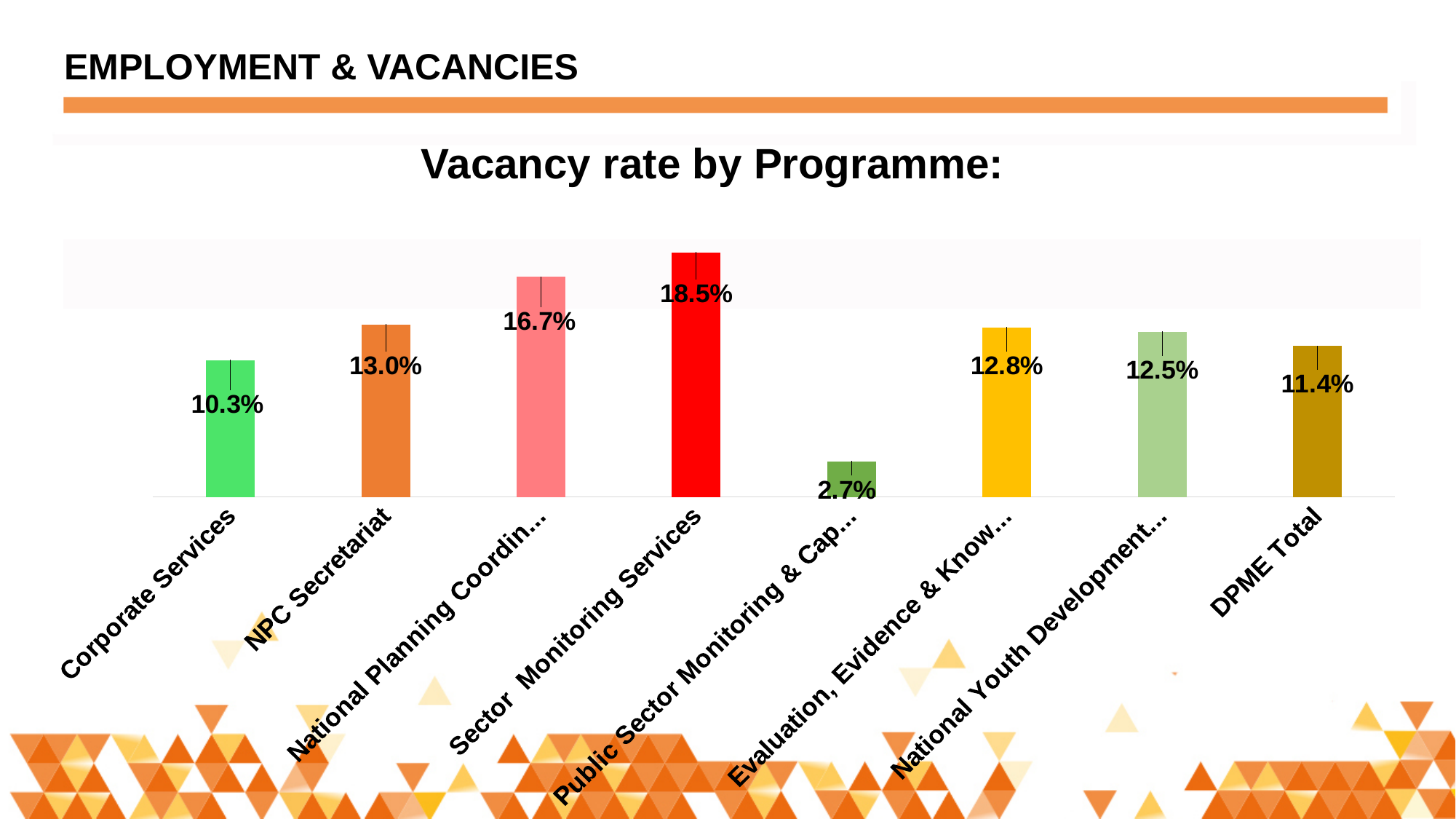
What is the vacancy rate for Sector Monitoring Services? 18.5% Which has a higher vacancy rate, NPC Secretariat or DPME Total? NPC Secretariat What type of chart is shown on the slide? Bar chart Which programme has the highest vacancy rate? Sector Monitoring Services What is the title of the chart? Vacancy rate by Programme: What is the vacancy rate for Corporate Services? 10.3% What is the vacancy rate for DPME Total? 11.4% What is the difference between the vacancy rates of Sector Monitoring Services and Corporate Services? 8.2% Which bar shows the lowest vacancy rate? Public Sector Monitoring & Cap... What is the vacancy rate for NPC Secretariat? 13.0% What colour is the bar for Sector Monitoring Services? Red How many bars are shown in the chart? 8